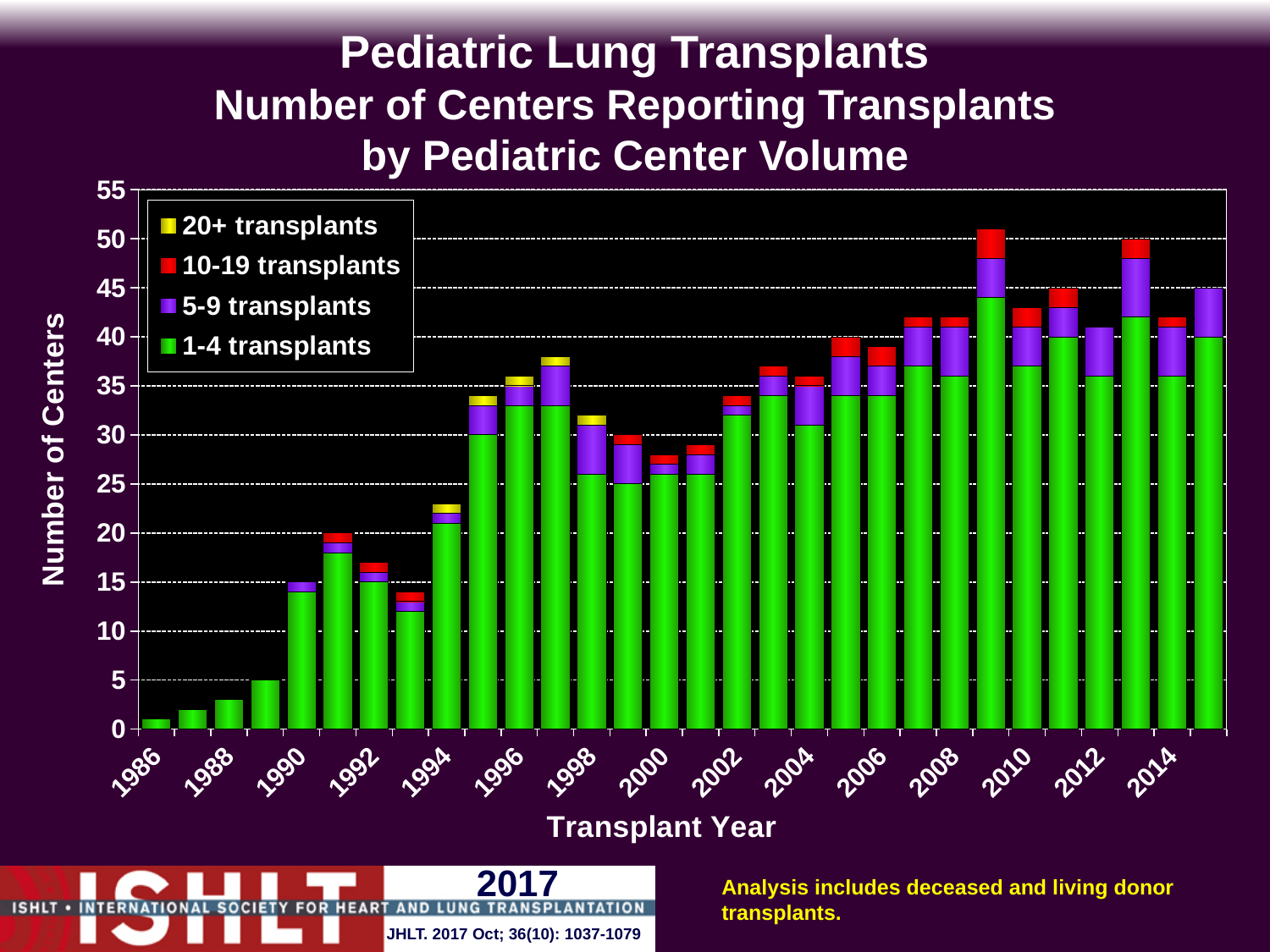
Is the total number of centers for 1990 greater or less than 10? greater Do the total bar heights rise or fall from 1986 to 1991? rise What is the title of the y axis? Number of Centers What kind of chart is shown on the slide? Stacked bar chart Which year has a taller total bar, 2009 or 2000? 2009 Is the total number of centers for 2011 greater or less than 40? greater Is the total number of centers for 1986 greater or less than 5? less How many series does the legend list? 4 Which year has a taller total bar, 1991 or 1993? 1991 Which transplant year has the lowest total number of centers? 1986